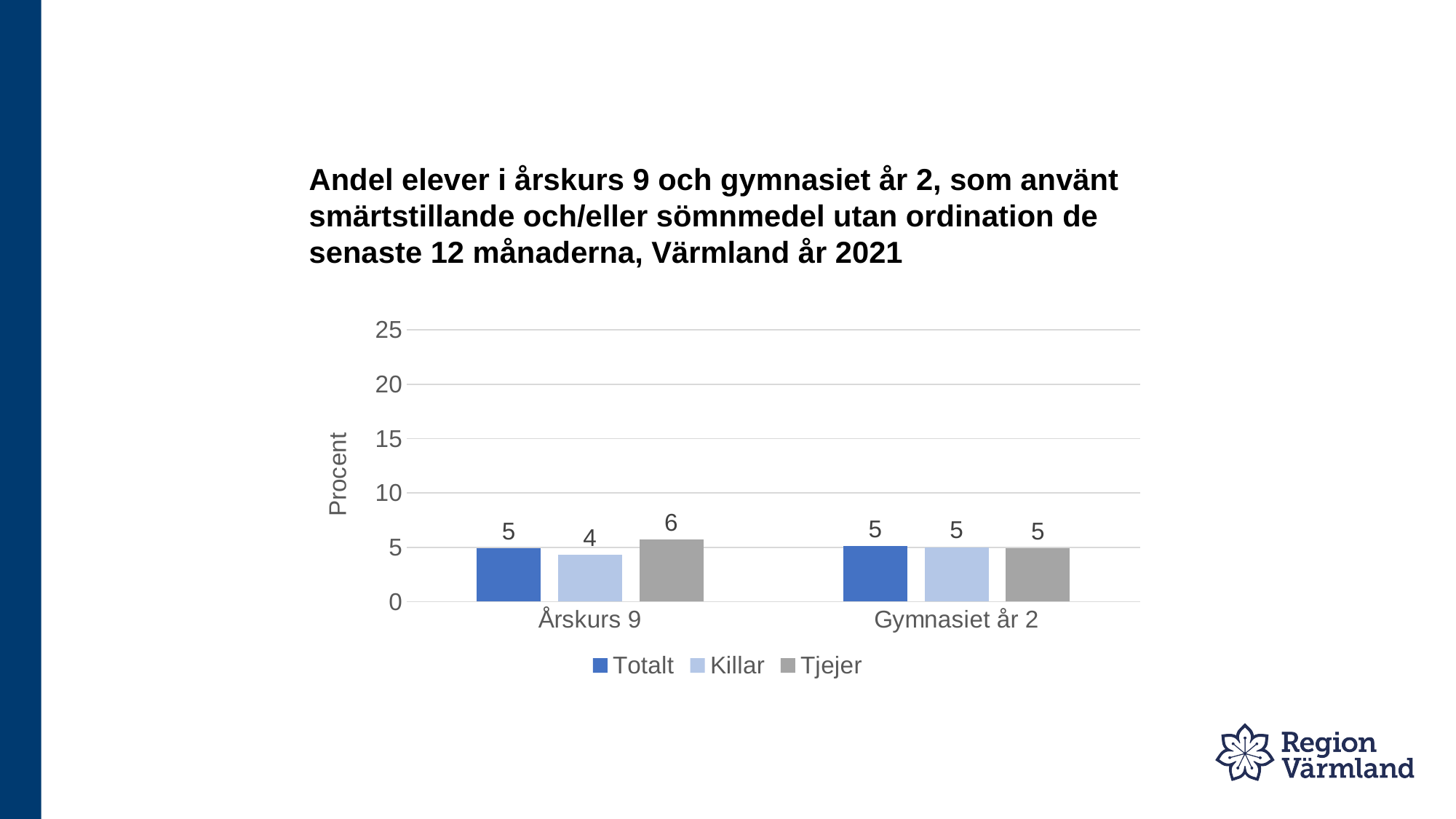
What is the value for Totalt in Gymnasiet år 2? 5 In Årskurs 9, which is larger: the value for Killar or the value for Tjejer? Tjejer What is the value for Killar in Årskurs 9? 4 What kind of chart is shown on the slide? bar chart Which series has the highest value in Årskurs 9? Tjejer How many series does the legend list? 3 What is the value for Tjejer in Årskurs 9? 6 What is the label on the y axis? Procent Is the value for Tjejer in Årskurs 9 greater or less than 5? greater Which series has the lowest value in Årskurs 9? Killar How many categories are shown on the x axis? 2 What is the difference between the Tjejer and Killar values in Årskurs 9? 2